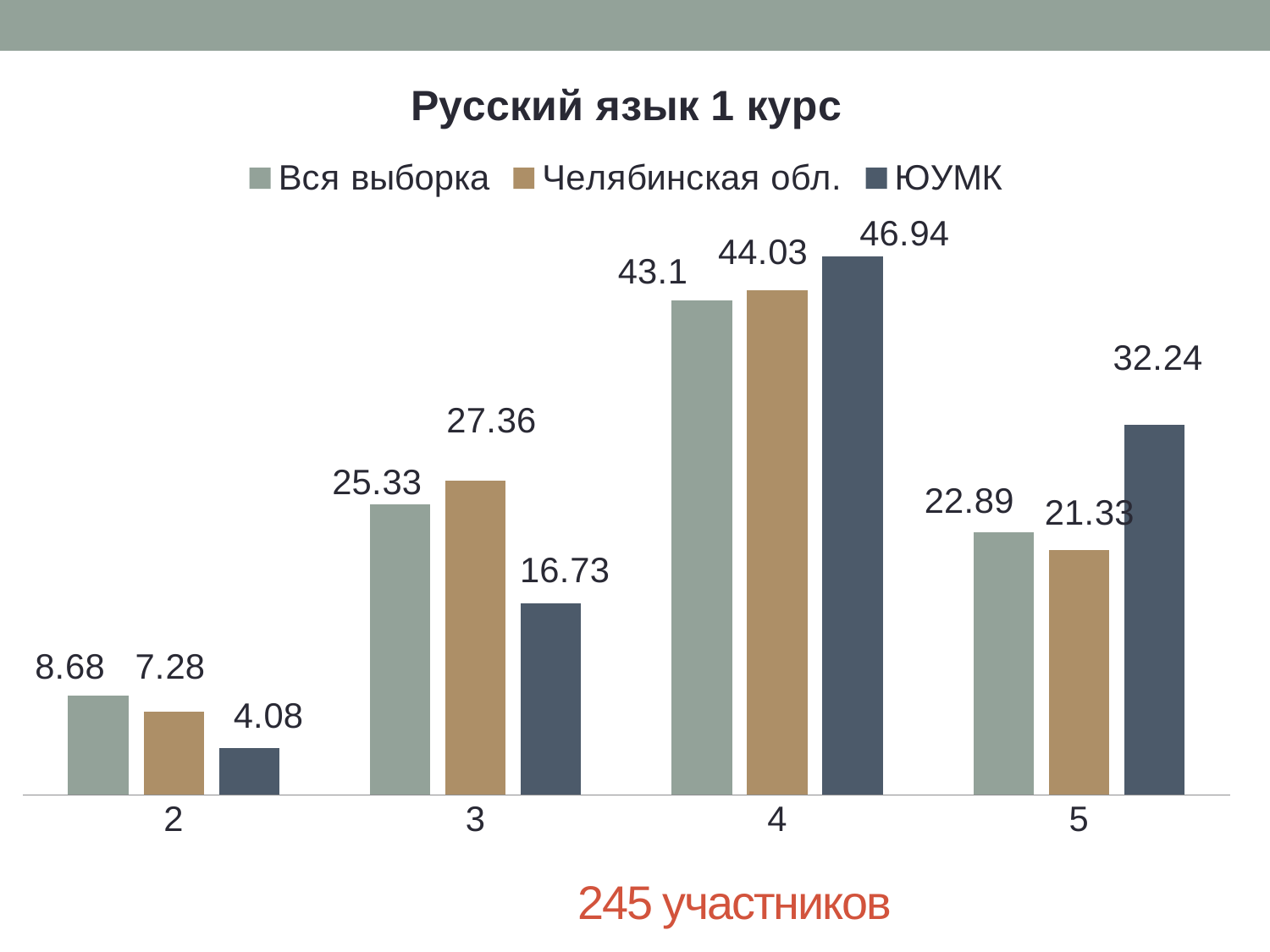
Which category has the highest value for Вся выборка? 4 How many categories are shown on the x axis? 4 How many series does the legend list? 3 Which is larger at category 3: Челябинская обл. or ЮУМК? Челябинская обл. What is the value for Челябинская обл. at category 5? 21.33 What is the title of the chart? Русский язык 1 курс What kind of chart is shown? Bar chart What is the difference between the Вся выборка and Челябинская обл. values at category 2? 1.4 What is the difference between the ЮУМК and Челябинская обл. values at category 5? 10.91 What is the value for Вся выборка at category 3? 25.33 What is the value for ЮУМК at category 4? 46.94 Which category has the lowest value for ЮУМК? 2